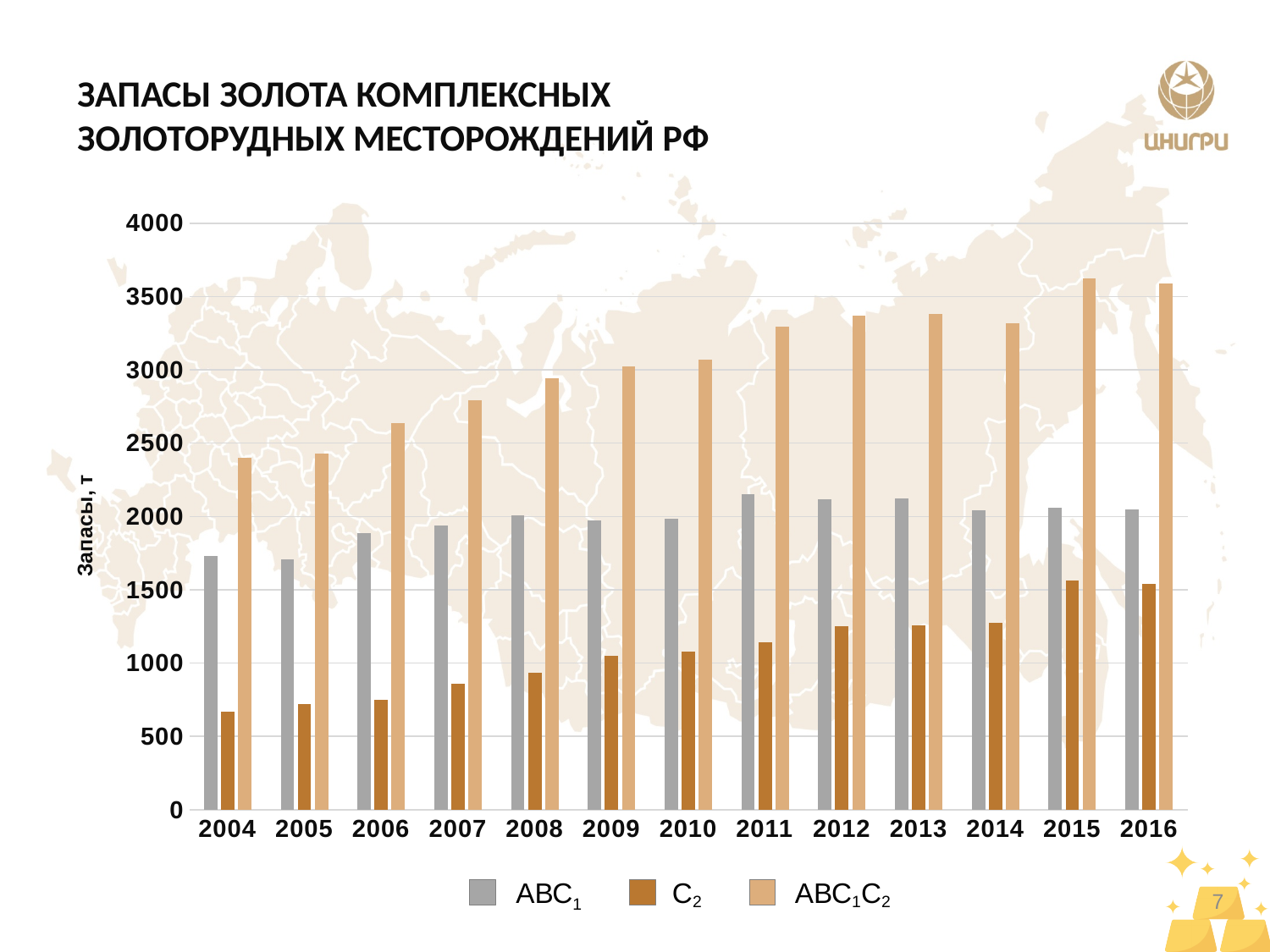
Which is larger in 2010, the ABC1 value or the C2 value? ABC1 Do the C2 values generally rise or fall from 2004 to 2016? rise In which year is the C2 value the lowest? 2004 Is the ABC1C2 value for 2016 greater or less than 3500? greater What kind of chart is shown on the slide? bar chart Is the ABC1 value for 2004 greater or less than 2000? less How many years are shown on the x axis of the chart? 13 Is the ABC1C2 value for 2004 greater or less than 2500? less What is the label on the y axis of the chart? Запасы, т How many series does the legend list? 3